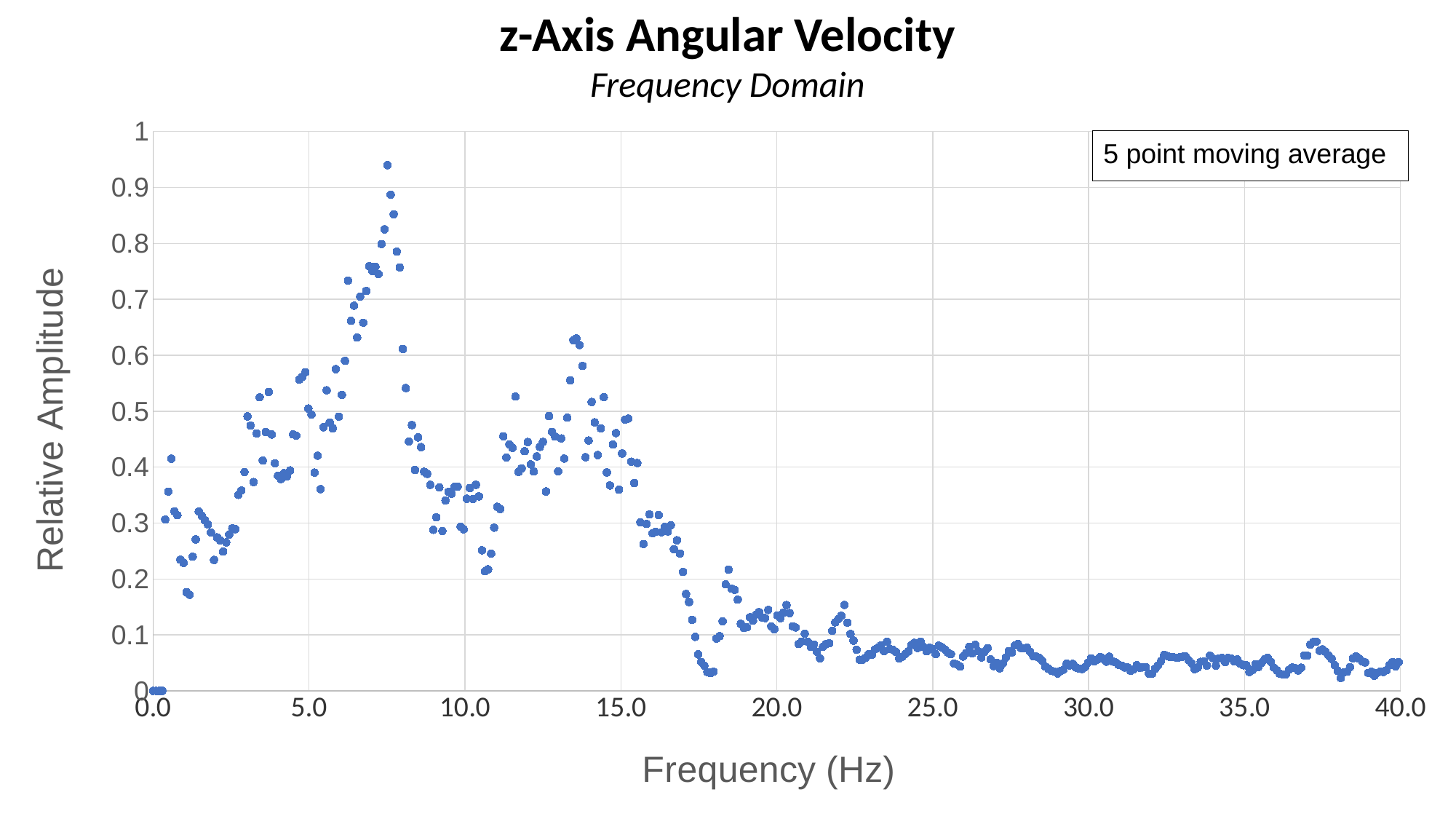
Is the peak value near 13.5 Hz greater or less than 0.5? greater What kind of chart is shown on the slide? Scatter plot Is the highest point on the chart greater or less than 0.9 in relative amplitude? greater Are the values around 20.0 Hz greater or less than 0.2? less Is the highest point on the chart located at a frequency greater or less than 10.0 Hz? less Which is larger: the peak near 7.5 Hz or the peak near 13.5 Hz? The peak near 7.5 Hz Do the values generally rise or fall as frequency increases from 15.0 Hz to 18.0 Hz? fall Do the values generally rise or fall as frequency increases from 0.0 Hz to 7.5 Hz? rise What text appears in the boxed annotation in the upper right of the chart? 5 point moving average What is the label of the vertical axis? Relative Amplitude